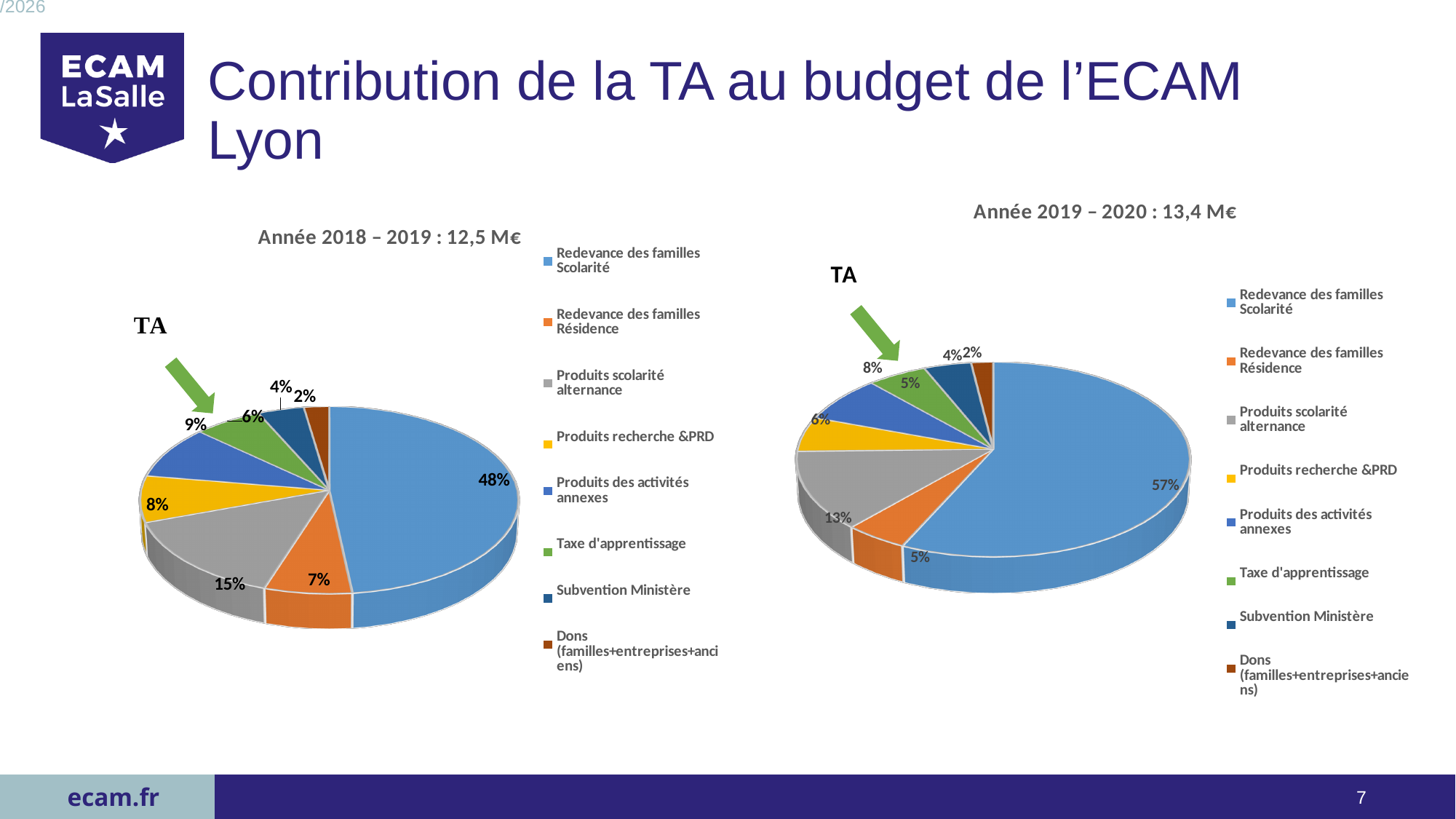
In the 'Année 2018 – 2019 : 12,5 M€' chart, what share does Subvention Ministère represent? 4% How many categories does the legend of the 'Année 2019 – 2020 : 13,4 M€' chart list? 8 What kind of chart is used for 'Année 2018 – 2019 : 12,5 M€'? Pie chart In the 'Année 2018 – 2019 : 12,5 M€' chart, what share does Taxe d'apprentissage represent? 6% In the 'Année 2019 – 2020 : 13,4 M€' chart, what share does Taxe d'apprentissage represent? 5% In the 'Année 2019 – 2020 : 13,4 M€' chart, what share does Redevance des familles Scolarité represent? 57% In the 'Année 2019 – 2020 : 13,4 M€' chart, which category has the smallest slice? Dons (familles+entreprises+anciens) In the 'Année 2019 – 2020 : 13,4 M€' chart, which is larger: Produits des activités annexes or Produits recherche &PRD? Produits des activités annexes In the 'Année 2018 – 2019 : 12,5 M€' chart, which category has the largest slice? Redevance des familles Scolarité In the 'Année 2018 – 2019 : 12,5 M€' chart, what is the difference between the Produits scolarité alternance share and the Redevance des familles Résidence share? 8% In the 'Année 2018 – 2019 : 12,5 M€' chart, what share does Redevance des familles Scolarité represent? 48% In the 'Année 2019 – 2020 : 13,4 M€' chart, what share does Produits scolarité alternance represent? 13%